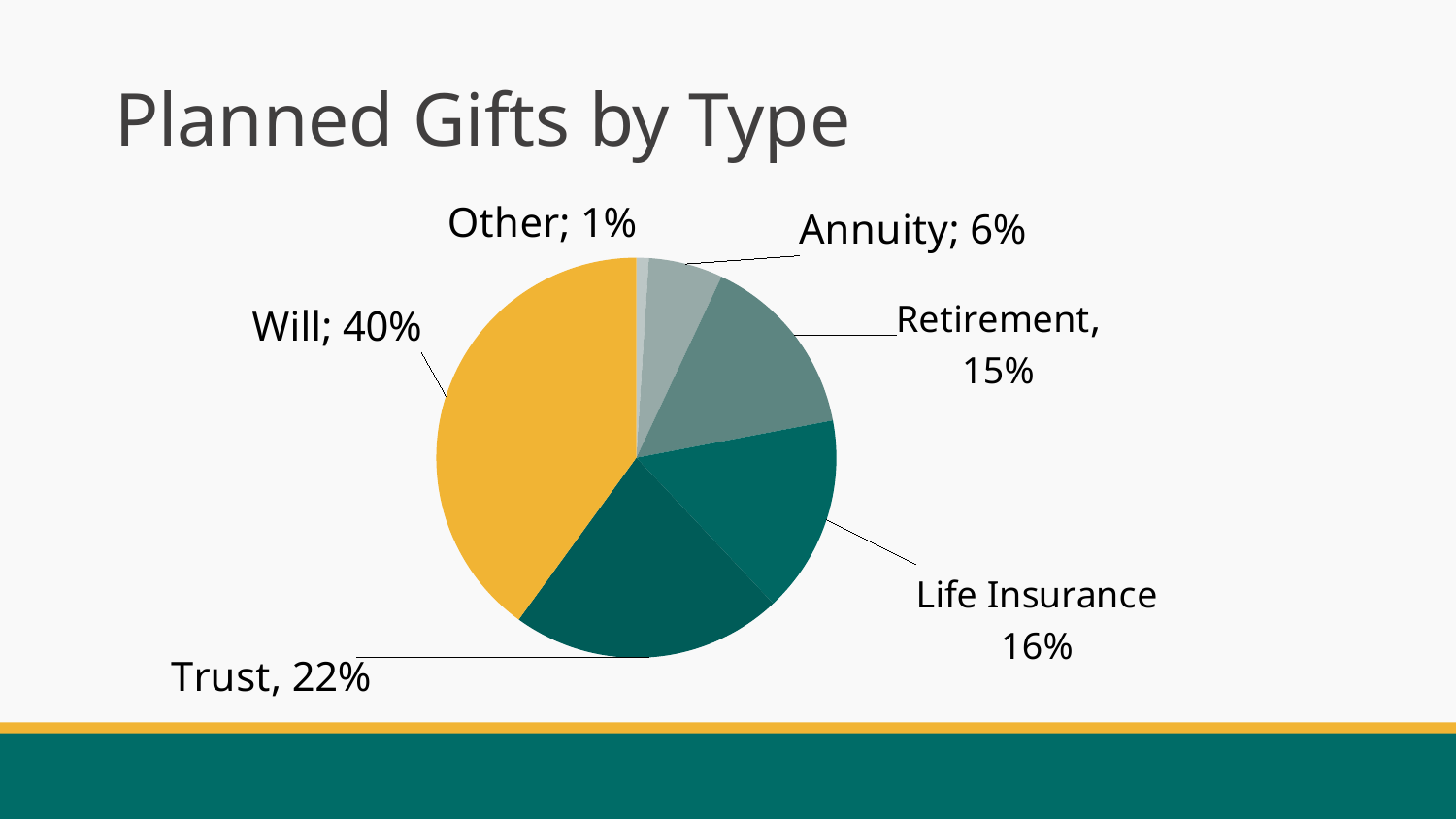
How many gift types are shown in the pie chart? 6 What percentage is shown for Retirement? 15% What share of planned gifts is Life Insurance? 16% Which gift type has the largest share of the pie? Will What percentage is shown for Annuity? 6% What is the difference in percentage points between Will and Trust? 18 What is the title of the chart? Planned Gifts by Type What percentage of planned gifts are Wills? 40% What percentage of planned gifts are Trusts? 22% What type of chart is shown on the slide? Pie chart Which is larger, the share for Life Insurance or the share for Annuity? Life Insurance Which gift type has the smallest share of the pie? Other